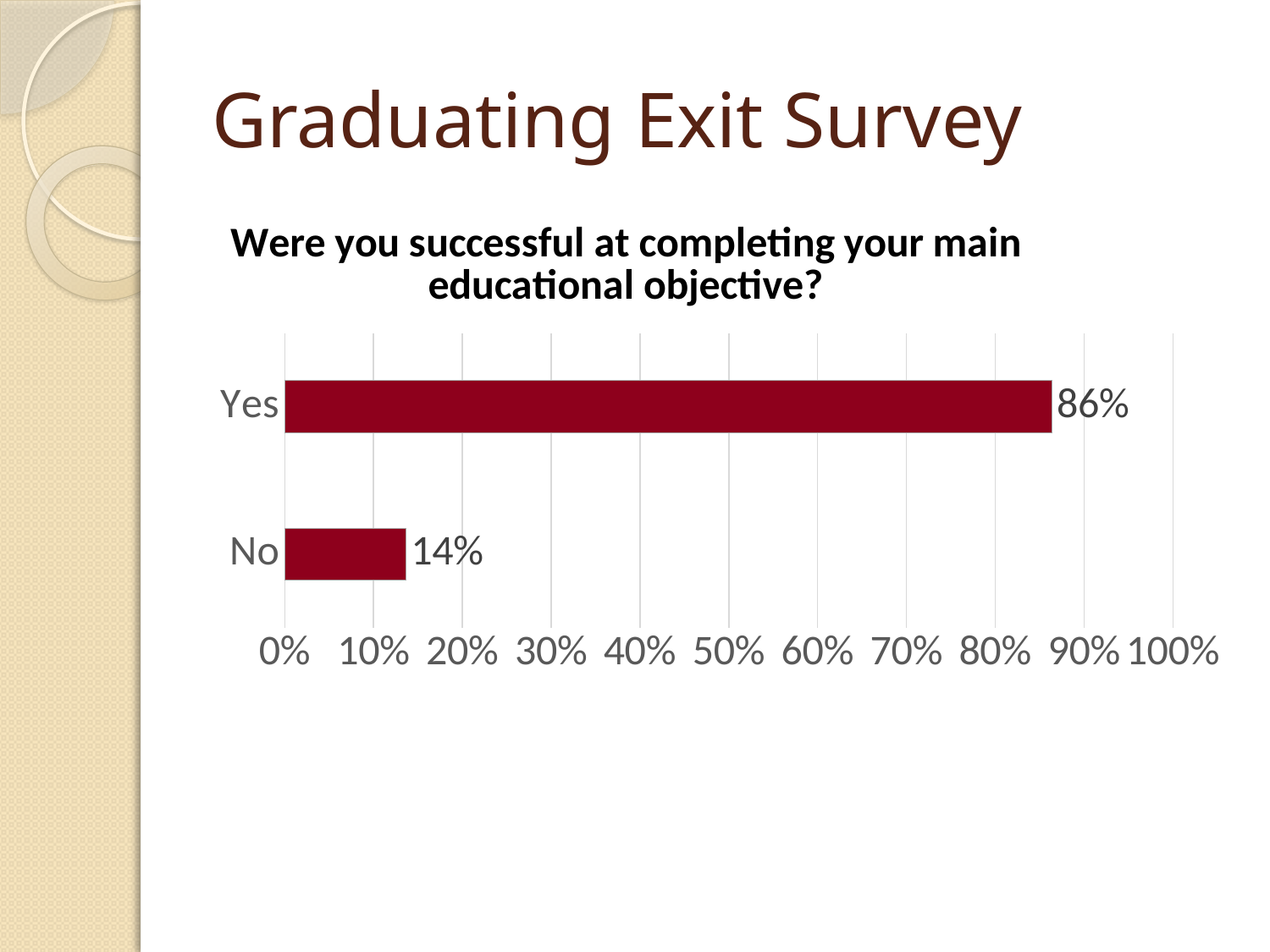
What percentage of respondents answered Yes? 86% Is the value for No greater or less than 20%? less What is the maximum value shown on the horizontal axis? 100% Which response has the highest value? Yes Is the value for Yes greater or less than 80%? greater What percentage of respondents answered No? 14% Which response has the lowest value? No What kind of chart is shown on the slide? bar chart What is the title of the chart? Were you successful at completing your main educational objective? What is the difference between the Yes and No percentages? 72% Which is larger, the value for Yes or the value for No? Yes How many response categories are shown in the chart? 2